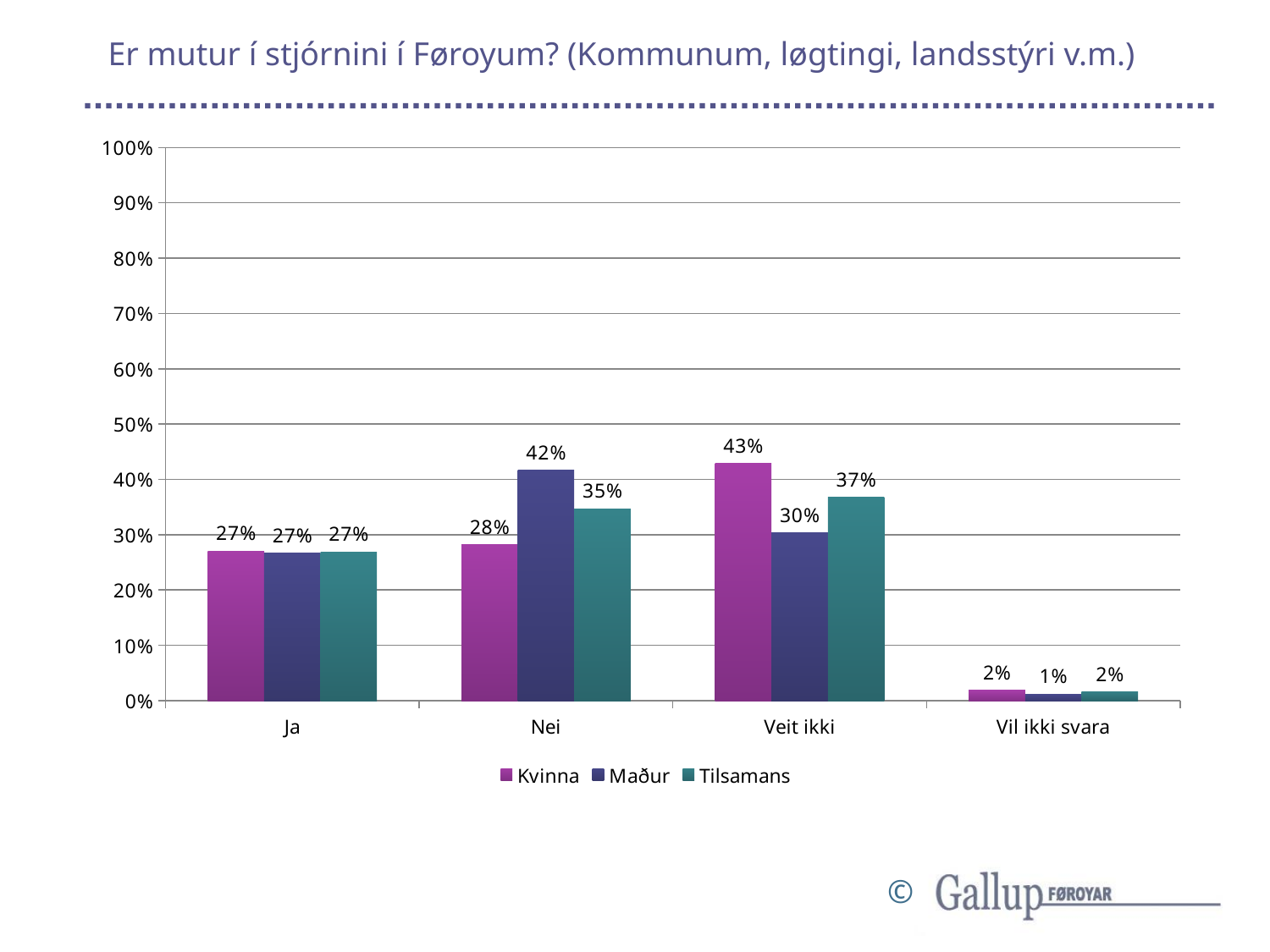
What is the value for Kvinna in the Veit ikki category? 43% Which is larger in the Nei category, the Kvinna value or the Maður value? Maður Which category has the highest value for the Maður series? Nei Which category has the lowest value for the Tilsamans series? Vil ikki svara What is the value for Tilsamans in the Ja category? 27% What kind of chart is shown on the slide? Bar chart What is the title of the chart? Er mutur í stjórnini í Føroyum? (Kommunum, løgtingi, landsstýri v.m.) What is the value for Maður in the Nei category? 42% How many categories are shown on the x axis? 4 How many series does the legend list? 3 What is the value for Maður in the Vil ikki svara category? 1% What is the difference between the Kvinna and Maður values in the Veit ikki category? 13%